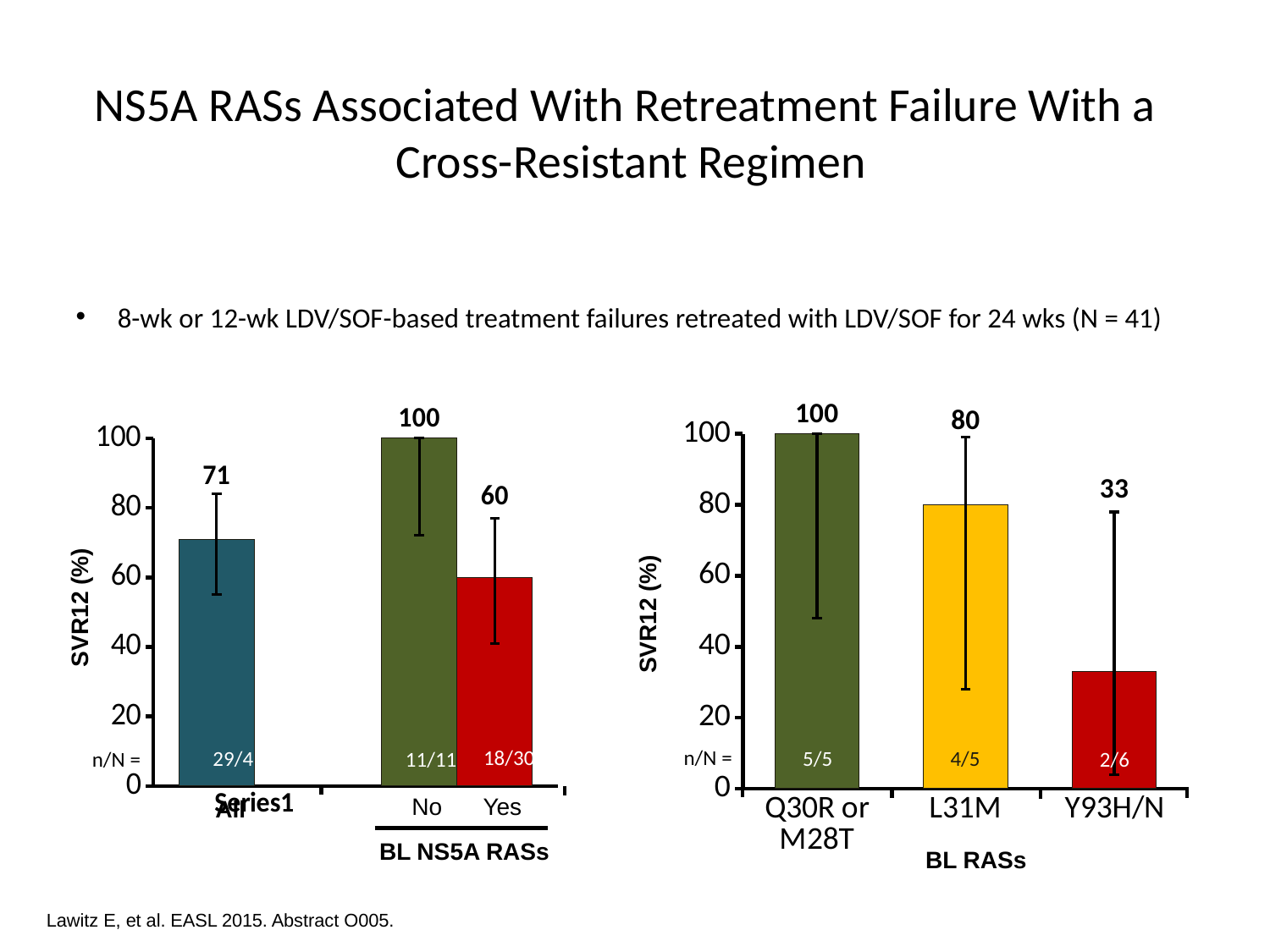
In the right chart, what is the n/N shown for Q30R or M28T? 5/5 In the left chart, what is the difference in SVR12 (%) between the 'No' and 'Yes' BL NS5A RASs bars? 40 In the right chart, what is the SVR12 (%) value for L31M? 80 In the left chart, which bar has the lowest SVR12 (%)? Yes (BL NS5A RASs) In the right chart, what is the SVR12 (%) value for Y93H/N? 33 In the left chart, what is the n/N shown for the 'Yes' BL NS5A RASs bar? 18/30 In the left chart, what is the SVR12 (%) value for patients with no BL NS5A RASs? 100 What type of chart is the right chart? Bar chart How many categories are plotted in the right chart? 3 In the left chart, what is the SVR12 (%) value for patients with BL NS5A RASs (Yes)? 60 In the right chart, what is the difference in SVR12 (%) between L31M and Y93H/N? 47 In the right chart, which BL RAS category has the highest SVR12 (%)? Q30R or M28T